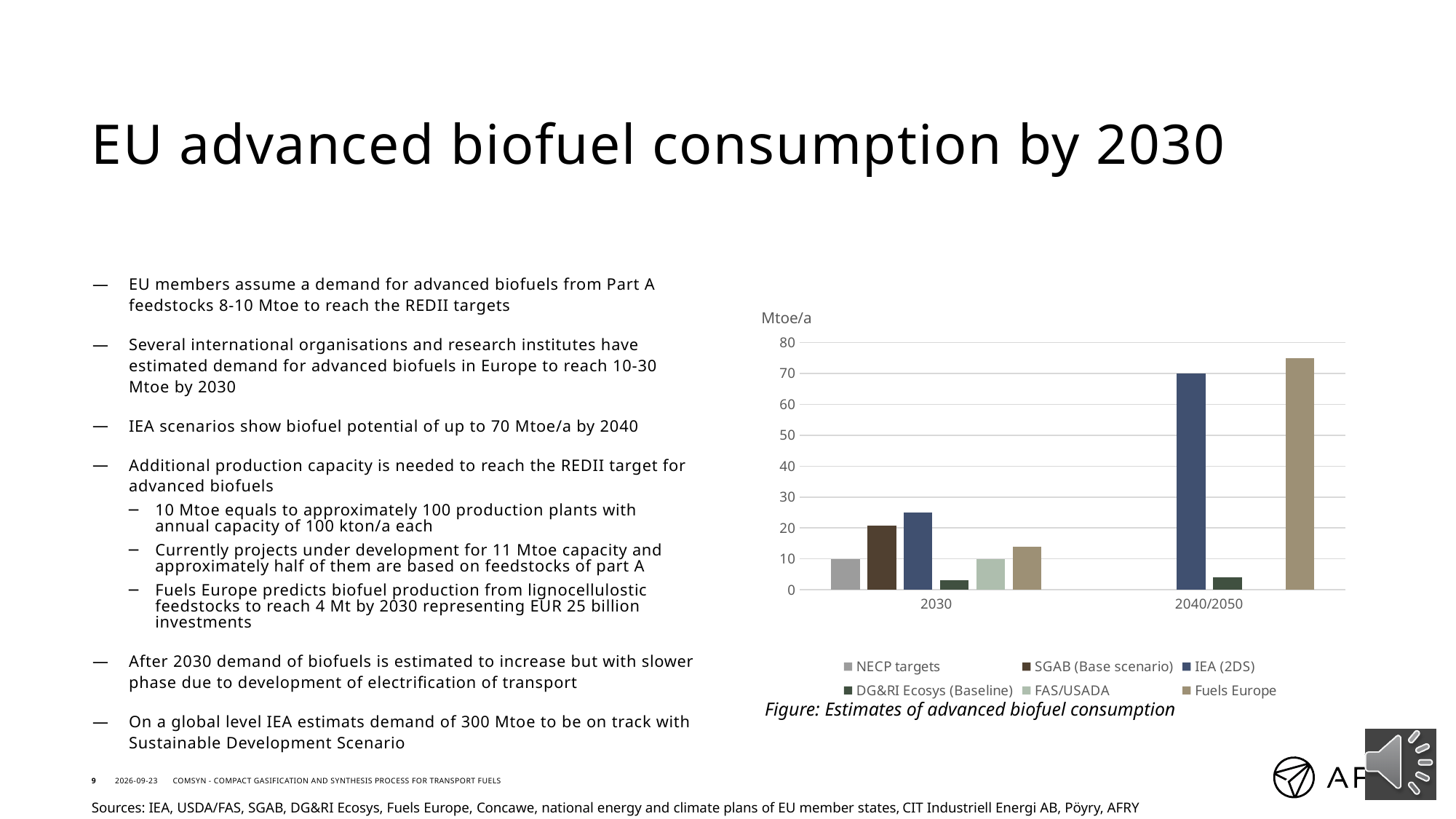
Which series has the highest value in the 2030 category? IEA (2DS) How many series does the chart legend list? 6 Is the value for SGAB (Base scenario) in 2030 greater or less than 30? less What is the value for IEA (2DS) in the 2040/2050 category? 70 Is the value for Fuels Europe in the 2040/2050 category greater or less than 70? greater How many categories are shown on the x axis of the chart? 2 What unit is shown on the y axis of the chart? Mtoe/a In the 2030 category, which is larger: IEA (2DS) or SGAB (Base scenario)? IEA (2DS) Does the IEA (2DS) value rise or fall from 2030 to 2040/2050? rise What kind of chart is shown on the slide? bar chart Which series has the highest value in the 2040/2050 category? Fuels Europe Which series has the lowest value in the 2030 category? DG&RI Ecosys (Baseline)